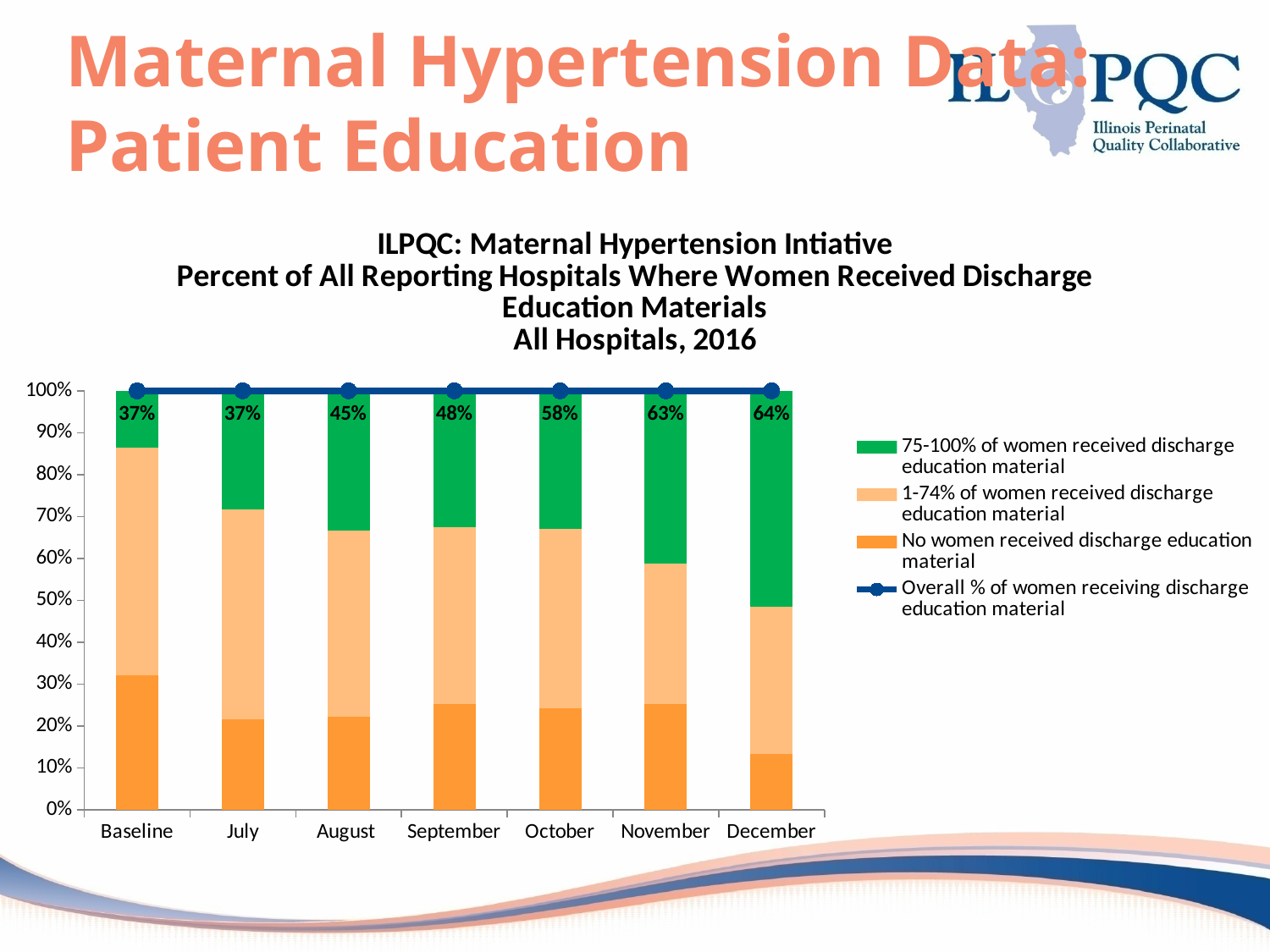
What percentage label is shown for Baseline? 37% What percentage label is shown for December? 64% What is the difference between the percentage labels for December and Baseline? 27 percentage points Is the 'No women received discharge education material' segment for December greater or less than 20%? less Which month has the highest percentage label? December How many time periods are shown on the x axis? 7 What kind of chart is shown on the slide? Stacked bar chart with a line What percentage label is shown for October? 58% Is the 'No women received discharge education material' segment for Baseline greater or less than 20%? greater How many entries does the legend list? 4 Do the percentage labels rise or fall from Baseline to December? rise Which has the larger percentage label, September or October? October